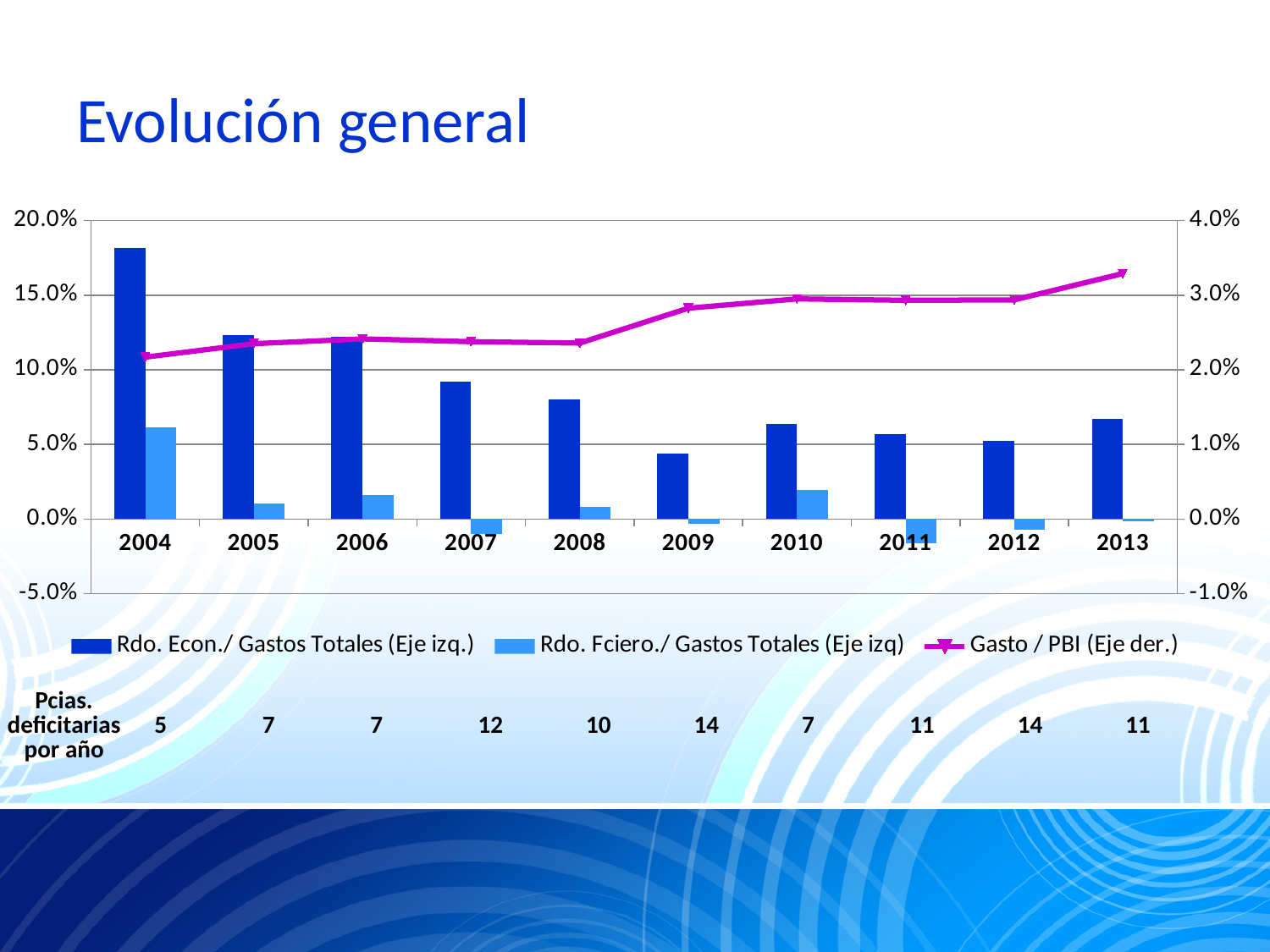
In which year is the Rdo. Econ./ Gastos Totales bar the lowest? 2009 How many series does the legend list? 3 How many years are shown on the x axis? 10 What kind of chart is shown on the slide? A combination bar and line chart Is the Rdo. Fciero./ Gastos Totales value for 2004 greater or less than 5.0%? greater Does the Gasto / PBI line generally rise or fall from 2004 to 2013? rise Is the Rdo. Econ./ Gastos Totales value for 2004 greater or less than 15.0%? greater Is the Rdo. Econ./ Gastos Totales value for 2007 greater or less than 10.0%? less In which year is the Rdo. Econ./ Gastos Totales bar the highest? 2004 Which legend entry is plotted on the right-hand axis (Eje der.)? Gasto / PBI (Eje der.) Which is larger, the Rdo. Econ./ Gastos Totales bar for 2005 or for 2008? 2005